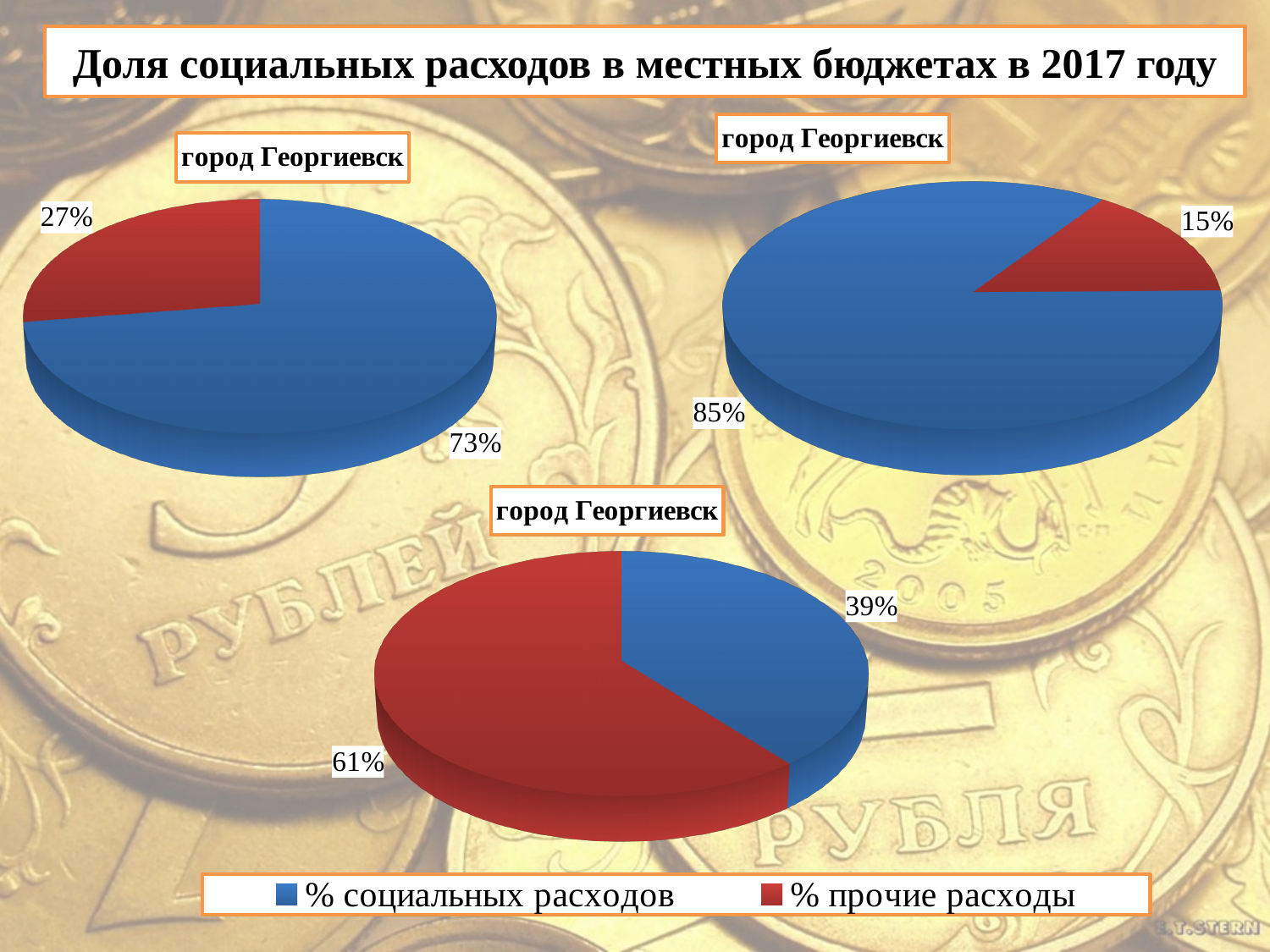
How many series does the legend list? 2 What kind of chart is used on this slide? Pie chart In the top-left pie chart, what is the difference between % социальных расходов and % прочие расходы? 46% In the bottom pie chart, what is the value for % социальных расходов? 39% What colour represents % прочие расходы in the legend? Red In the top-right pie chart, what is the difference between % социальных расходов and % прочие расходы? 70% In the top-right pie chart, what is the value for % социальных расходов? 85% In the bottom pie chart, what is the value for % прочие расходы? 61% In the bottom pie chart, which slice is larger: % социальных расходов or % прочие расходы? % прочие расходы In the top-left pie chart, what is the value for % прочие расходы? 27% In the top-left pie chart, what is the value for % социальных расходов? 73% In the top-right pie chart, what is the value for % прочие расходы? 15%